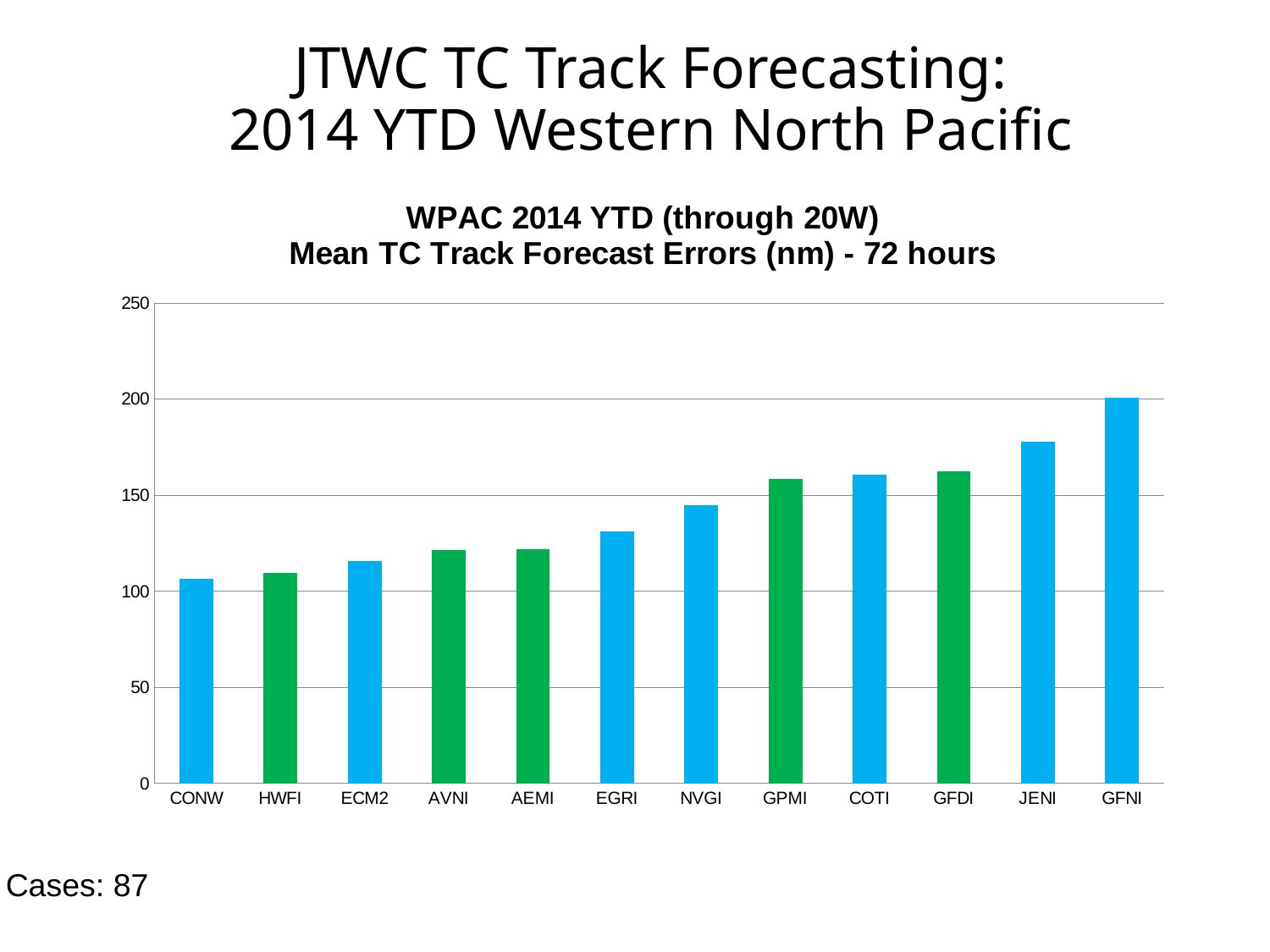
Is the value for CONW greater or less than 100? greater Do the bar values generally rise or fall from left to right across the x axis? rise Is the value for AVNI greater or less than 150? less What forecast lead time does the chart title say the mean track errors are for? 72 hours Is the value for GFNI greater or less than 150? greater How many models (categories) are shown on the x axis of the chart? 12 Which model has the highest mean 72-hour track forecast error? GFNI What kind of chart is shown on the slide? bar chart Which has a larger mean track forecast error, JENI or NVGI? JENI Which has a larger mean track forecast error, EGRI or GPMI? GPMI